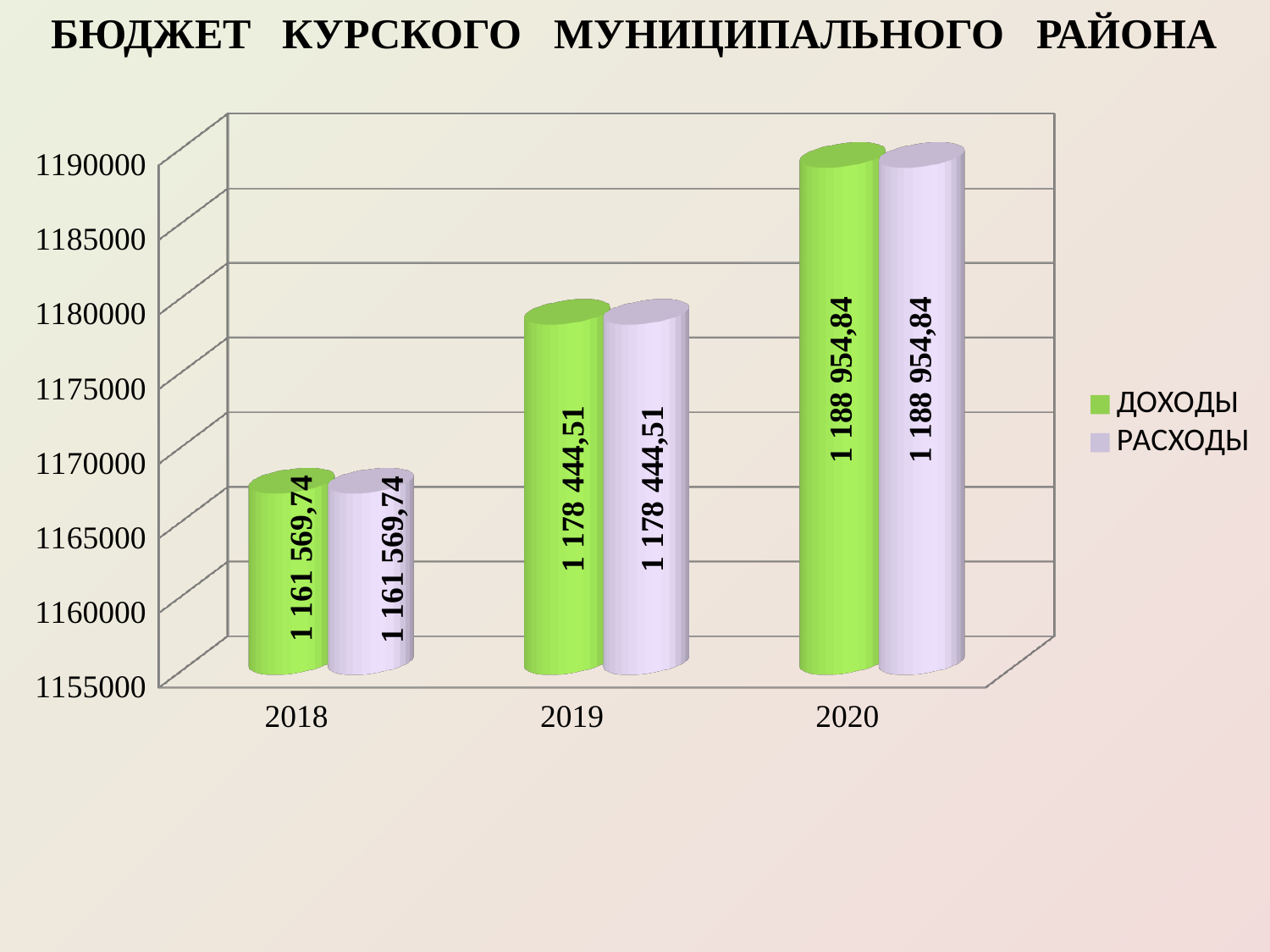
What is the value of ДОХОДЫ for 2020? 1 188 954,84 What is the difference between РАСХОДЫ in 2020 and РАСХОДЫ in 2019? 10 510,33 What is the value of ДОХОДЫ for 2018? 1 161 569,74 How many series does the legend list? 2 What is the difference between ДОХОДЫ in 2019 and ДОХОДЫ in 2018? 16 874,77 What kind of chart is shown on the slide? bar chart How many years are shown on the x axis? 3 In which year is РАСХОДЫ lowest? 2018 What is the value of РАСХОДЫ for 2019? 1 178 444,51 Which is larger: ДОХОДЫ in 2018 or ДОХОДЫ in 2020? ДОХОДЫ in 2020 Do the ДОХОДЫ values rise or fall from 2018 to 2020? rise In which year is ДОХОДЫ highest? 2020